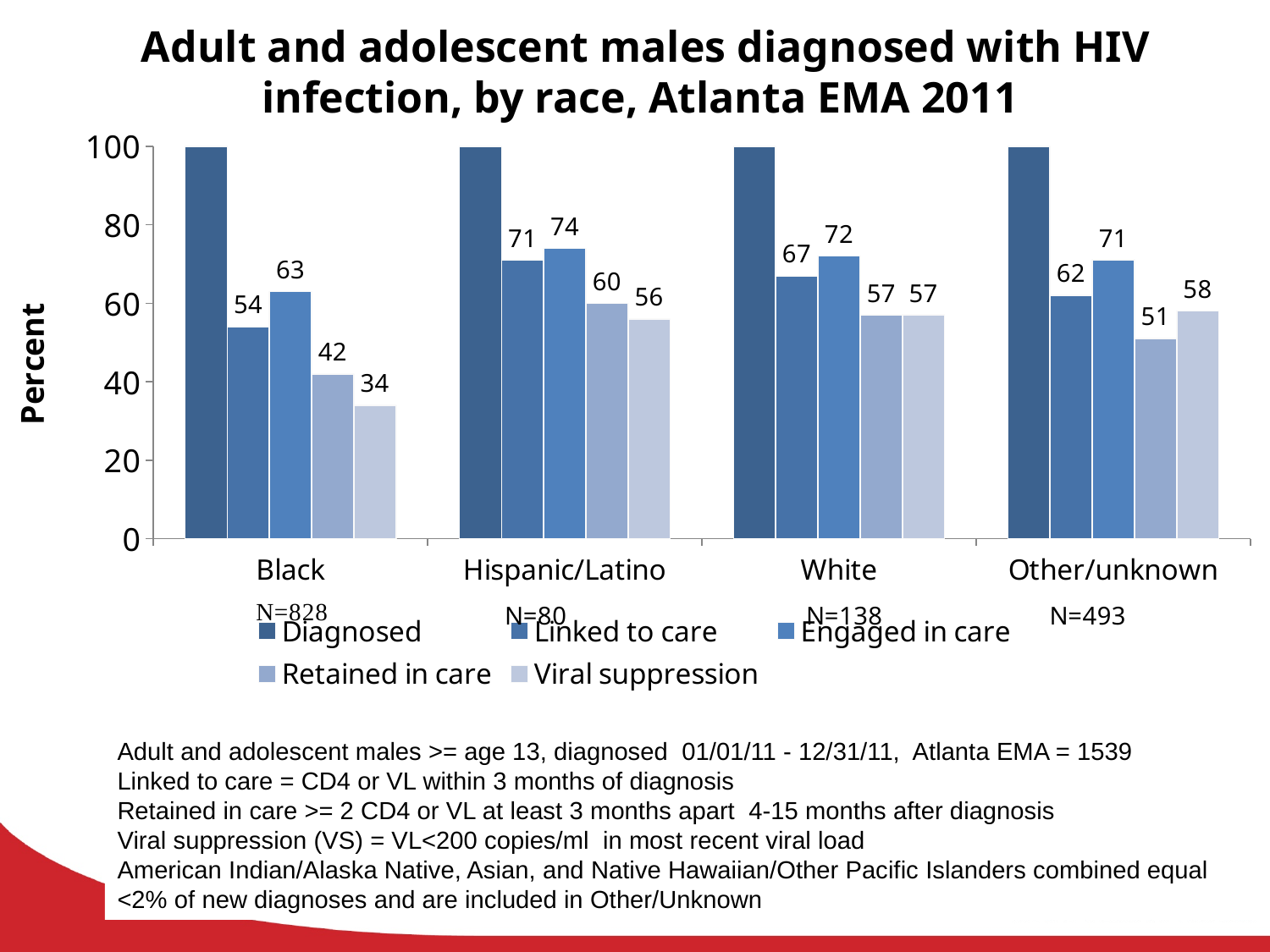
Which race group has the lowest Viral suppression value? Black What is the Viral suppression value for Black males? 34 Which race group has the highest Linked to care value? Hispanic/Latino Is the Engaged in care value for White males larger than the Engaged in care value for Other/unknown males? Yes What is the Retained in care value for White males? 57 What is the Linked to care value for Other/unknown males? 62 What is the difference between the Linked to care and Viral suppression values for Black males? 20 How many race groups are shown on the x axis? 4 What kind of chart is shown on the slide? Bar chart Is the Retained in care value for Black males greater or less than 40? greater How many series does the legend list? 5 What is the Engaged in care value for Hispanic/Latino males? 74